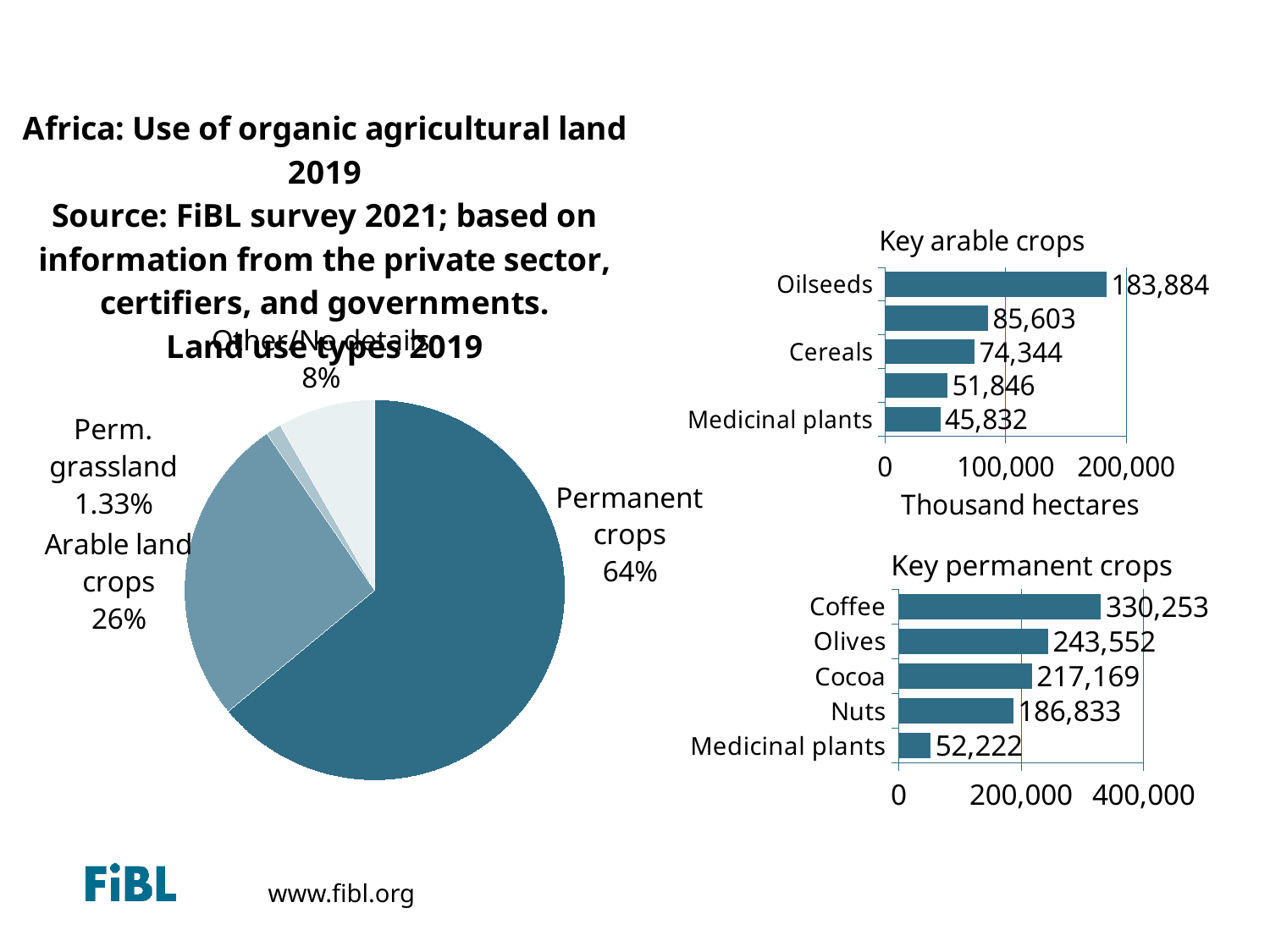
In the Key permanent crops chart, what is the value for Nuts? 186,833 How many bars are shown in the Key permanent crops chart? 5 In the Key permanent crops chart, which crop has the lowest value? Medicinal plants In the Key permanent crops chart, what is the value for Coffee? 330,253 In the Key arable crops chart, what is the difference between the values for Oilseeds and Cereals? 109,540 In the Key permanent crops chart, which is larger, the value for Cocoa or the value for Nuts? Cocoa In the Key arable crops chart, what is the value for Oilseeds? 183,884 In the Key permanent crops chart, what is the difference between the values for Olives and Cocoa? 26,383 In the Key arable crops chart, which crop has the highest value? Oilseeds In the Key arable crops chart, what is the value for Cereals? 74,344 What is the x-axis label of the Key arable crops chart? Thousand hectares In the Land use types 2019 pie chart, what share is Permanent crops? 64%